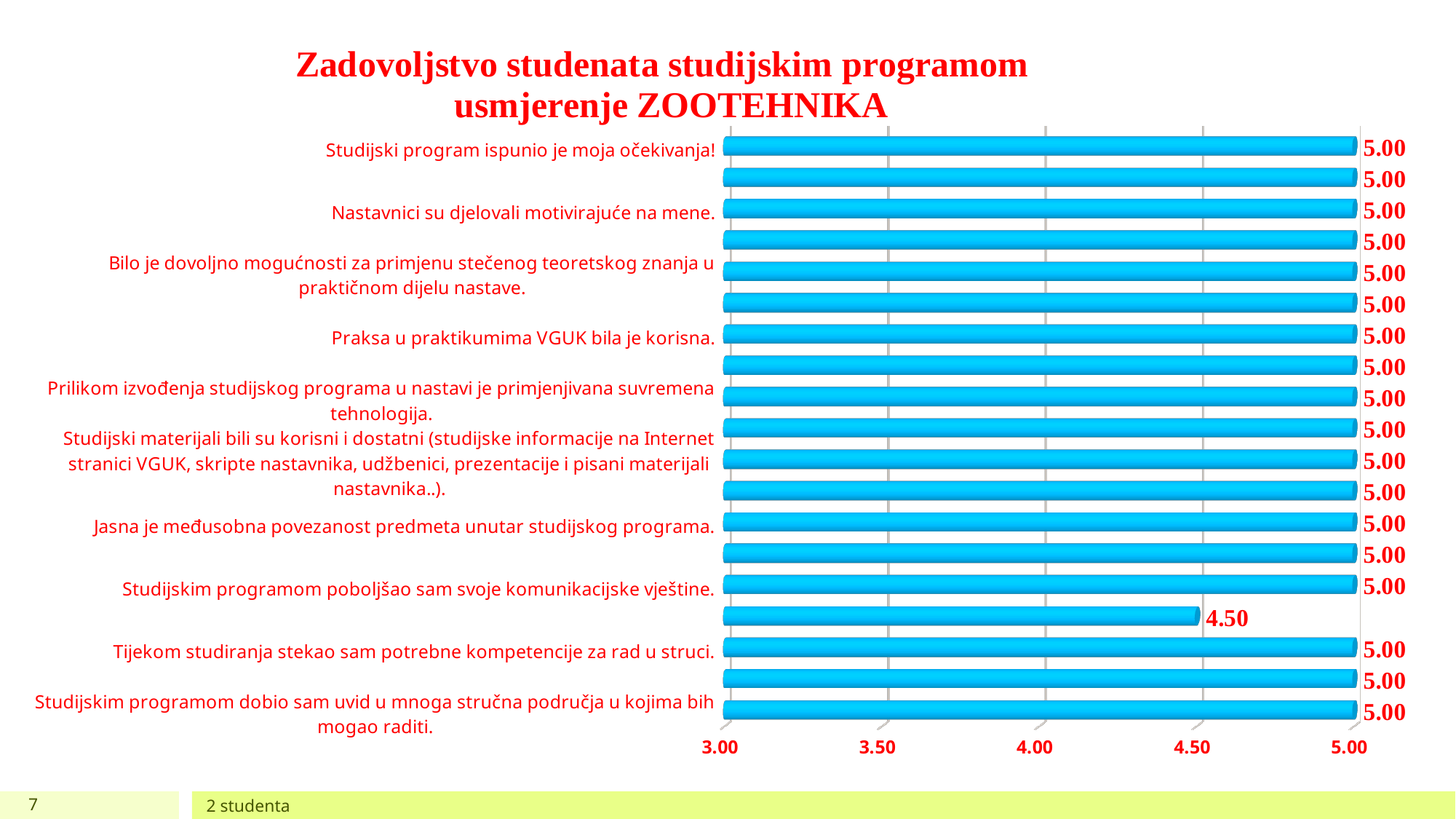
Is the value for "Studijskim programom poboljšao sam svoje komunikacijske vještine." greater or less than 4.50? greater How many bars are plotted on the chart? 19 What is the value for "Nastavnici su djelovali motivirajuće na mene."? 5.00 What is the title of the chart? Zadovoljstvo studenata studijskim programom usmjerenje ZOOTEHNIKA What is the lowest value shown on the chart? 4.50 What is the value for "Studijski program ispunio je moja očekivanja!"? 5.00 What is the value for "Praksa u praktikumima VGUK bila je korisna."? 5.00 How many bars have a value of 4.50? 1 What type of chart is shown on the slide? bar chart What is the value for "Jasna je međusobna povezanost predmeta unutar studijskog programa."? 5.00 What is the value for "Tijekom studiranja stekao sam potrebne kompetencije za rad u struci."? 5.00 What is the difference between the highest and the lowest value on the chart? 0.50